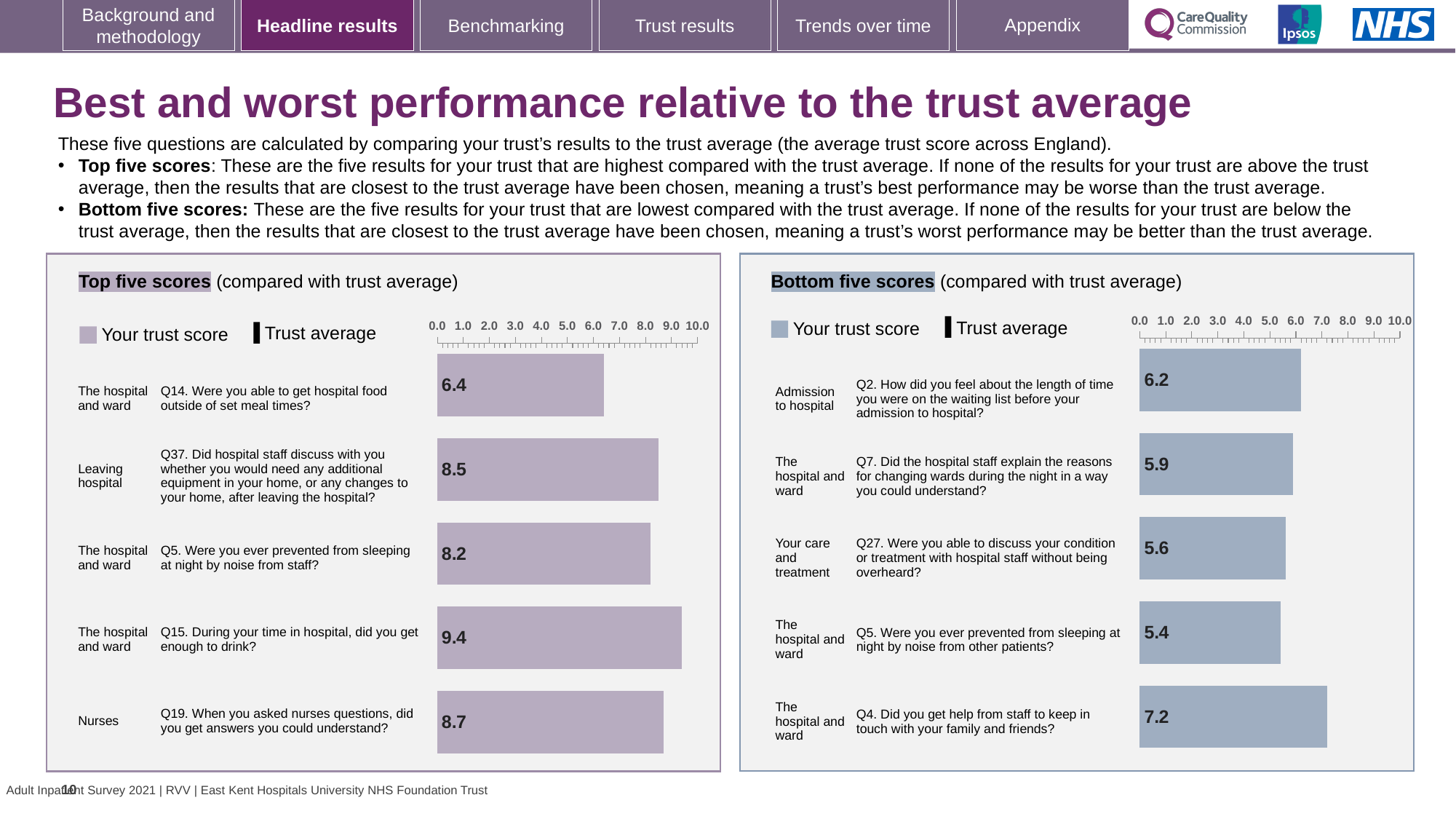
In the Top five scores chart, what is the trust score for Q15 (During your time in hospital, did you get enough to drink?)? 9.4 In the Bottom five scores chart, which question has the highest trust score? Q4 What kind of chart is the Top five scores chart? Bar chart In the Top five scores chart, which has a higher score: Q37 or Q5? Q37 In the Bottom five scores chart, what is the trust score for Q27 (Were you able to discuss your condition or treatment with hospital staff without being overheard?)? 5.6 In the Top five scores chart, which question has the highest trust score? Q15 In the Bottom five scores chart, which question has the lowest trust score? Q5 In the Top five scores chart, what is the difference between the scores for Q19 and Q14? 2.3 In the Top five scores chart, which question has the lowest trust score? Q14 How many questions are shown in the Bottom five scores chart? 5 In the Bottom five scores chart, what is the difference between the scores for Q4 and Q5? 1.8 In the Bottom five scores chart, is the score for Q2 greater or less than 5.0? greater